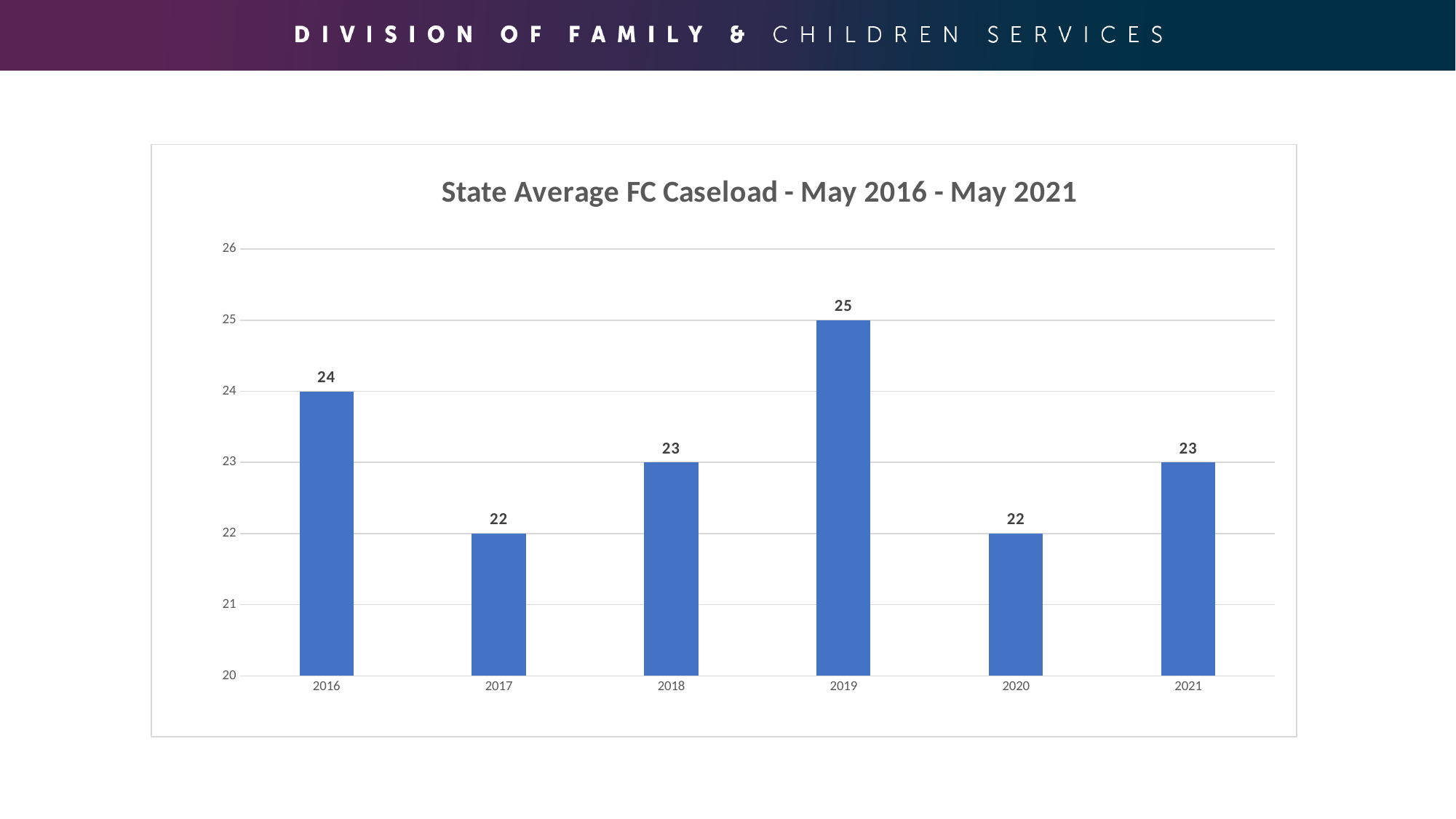
What is the title of the chart? State Average FC Caseload - May 2016 - May 2021 Did the state average FC caseload rise or fall from 2019 to 2020? Fall What is the state average FC caseload for 2021? 23 What is the state average FC caseload for 2019? 25 What is the state average FC caseload for 2016? 24 How many years are shown on the chart? 6 Which year has the highest state average FC caseload? 2019 Which is larger, the caseload in 2016 or the caseload in 2021? 2016 Which is larger, the caseload in 2018 or the caseload in 2020? 2018 What is the difference between the caseload in 2019 and the caseload in 2020? 3 What kind of chart is shown on the slide? Bar chart What is the difference between the caseload in 2016 and the caseload in 2017? 2